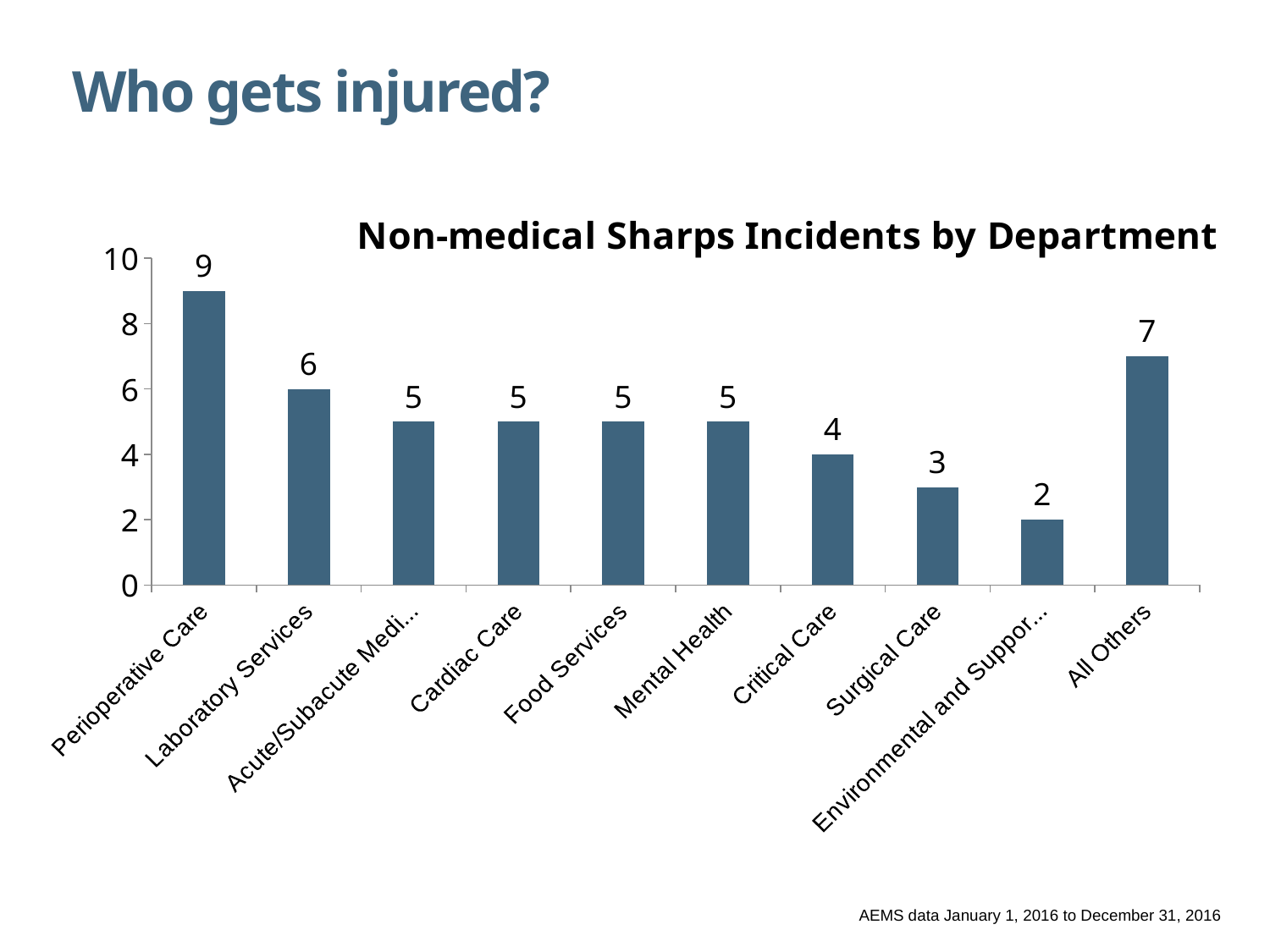
What is the value for Perioperative Care? 9 Which is larger, Laboratory Services or Critical Care? Laboratory Services What kind of chart is this? Bar chart What is the value for All Others? 7 Which department has the highest number of incidents? Perioperative Care What is the difference between Perioperative Care and Surgical Care? 6 What is the value for Critical Care? 4 What is the value for Laboratory Services? 6 What is the value for Mental Health? 5 What is the title of the chart? Non-medical Sharps Incidents by Department How many departments are shown on the x axis? 10 Which labelled department has the lowest number of incidents? Environmental and Support Services